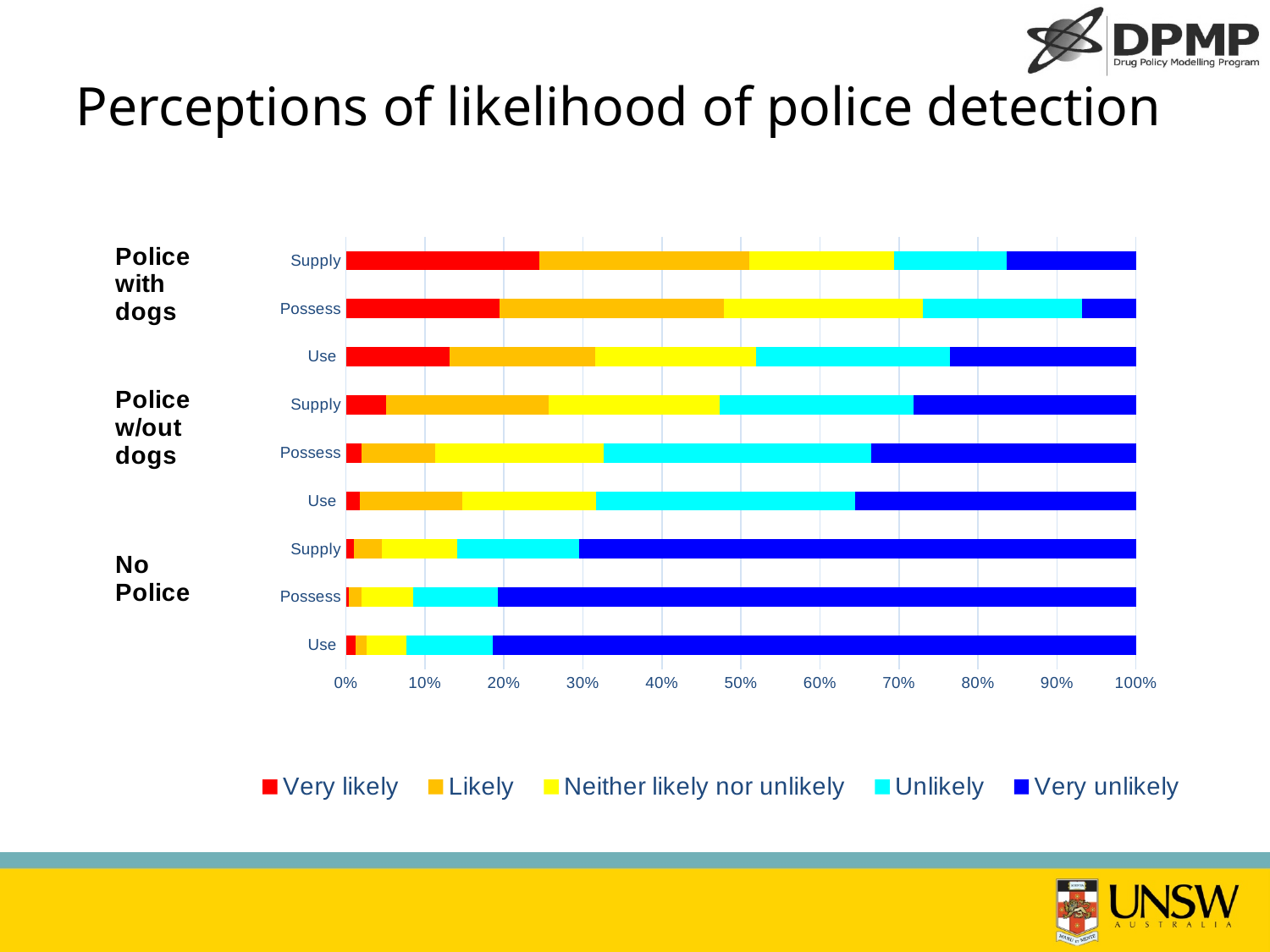
What is the title of the slide's chart? Perceptions of likelihood of police detection How many bars are plotted in the chart? 9 Is the 'Very unlikely' share for No Police – Supply greater or less than 60%? greater Which has the larger 'Very unlikely' segment: No Police – Supply or Police w/out dogs – Supply? No Police – Supply Which colour represents 'Very unlikely' in the legend? Dark blue Is the 'Very likely' share for Police with dogs – Supply greater or less than 20%? greater How many series does the legend list? 5 What kind of chart is shown on the slide? Stacked bar chart Which has the larger 'Very likely' segment: Police with dogs – Supply or Police with dogs – Possess? Police with dogs – Supply Which bar has the smallest 'Very unlikely' segment? Police with dogs – Possess Which bar has the largest 'Very likely' segment? Police with dogs – Supply Is the 'Very likely' share for Police with dogs – Use greater or less than 20%? less